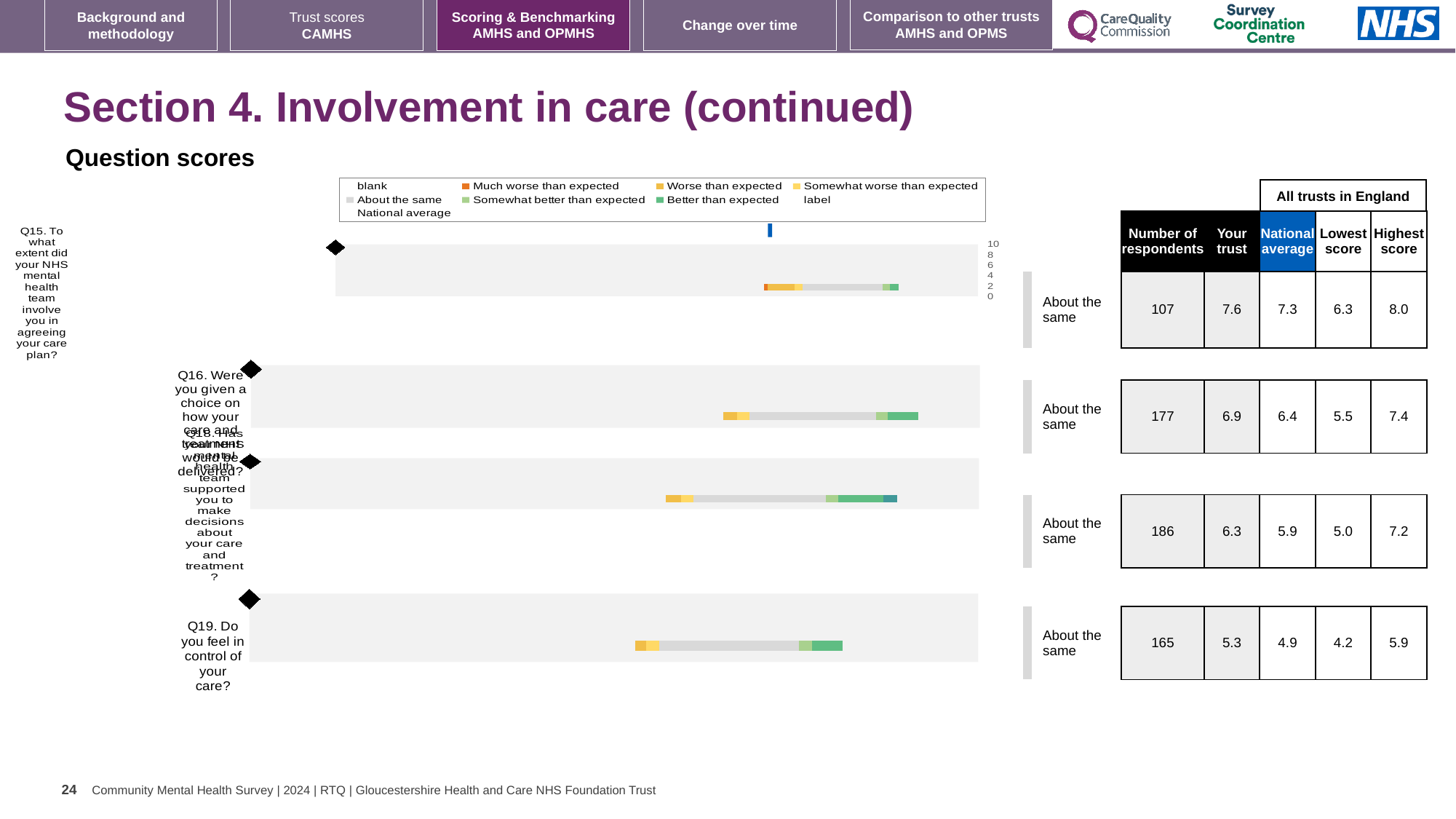
Which question has the largest number of respondents in the table beside the chart? Q18 What benchmark category is shown next to the chart for Q19? About the same In the table beside the chart, what is the highest score across all trusts in England for Q16? 7.4 Which question has the lowest 'Your trust' score in the table beside the chart? Q19 What is the difference between the 'Your trust' score and the national average for Q15? 0.3 How many questions (categories) are plotted in the question scores chart? 4 Which question has the highest 'Your trust' score in the table beside the chart? Q15 What kind of chart is used to show the question scores on this slide? bar chart In the table beside the chart, what is the national average for Q19 (Do you feel in control of your care)? 4.9 In the table beside the chart, what is the 'Your trust' score for Q15 (involvement in agreeing your care plan)? 7.6 In the table beside the chart, how many respondents answered Q18? 186 For Q16, which is larger: the 'Your trust' score or the national average? Your trust